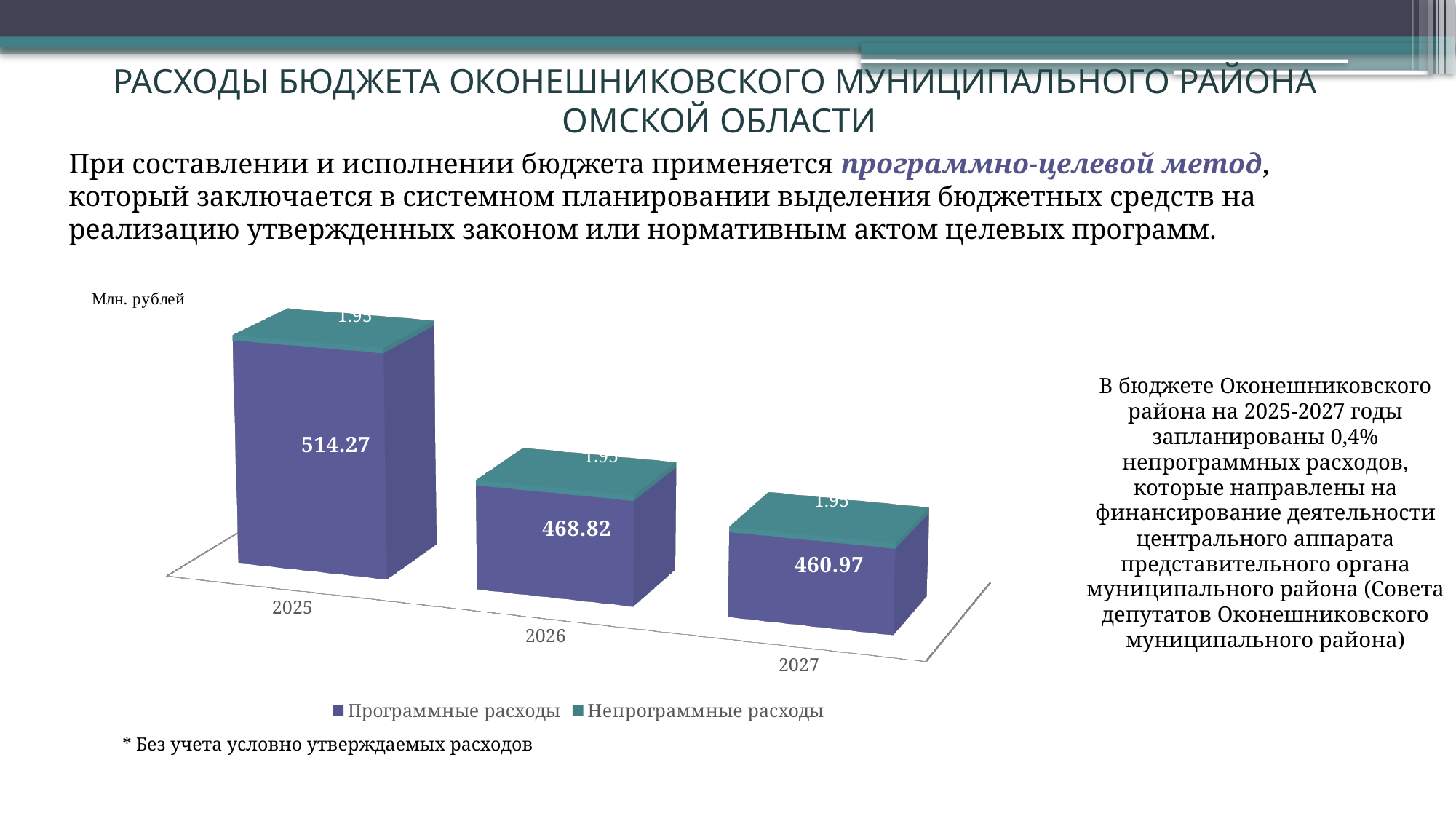
Which year has the highest value of Программные расходы? 2025 Which year has larger Программные расходы, 2026 or 2027? 2026 What is the value of Программные расходы for 2027? 460.97 How many years are shown on the x axis of the chart? 3 What is the value of Программные расходы for 2025? 514.27 What is the difference between Программные расходы in 2026 and 2027? 7.85 What is the difference between Программные расходы in 2025 and 2026? 45.45 How many series does the chart legend list? 2 What kind of chart is shown on the slide? bar chart Do the values of Программные расходы rise or fall from 2025 to 2027? fall What is the value of Программные расходы for 2026? 468.82 Which year has the lowest value of Программные расходы? 2027